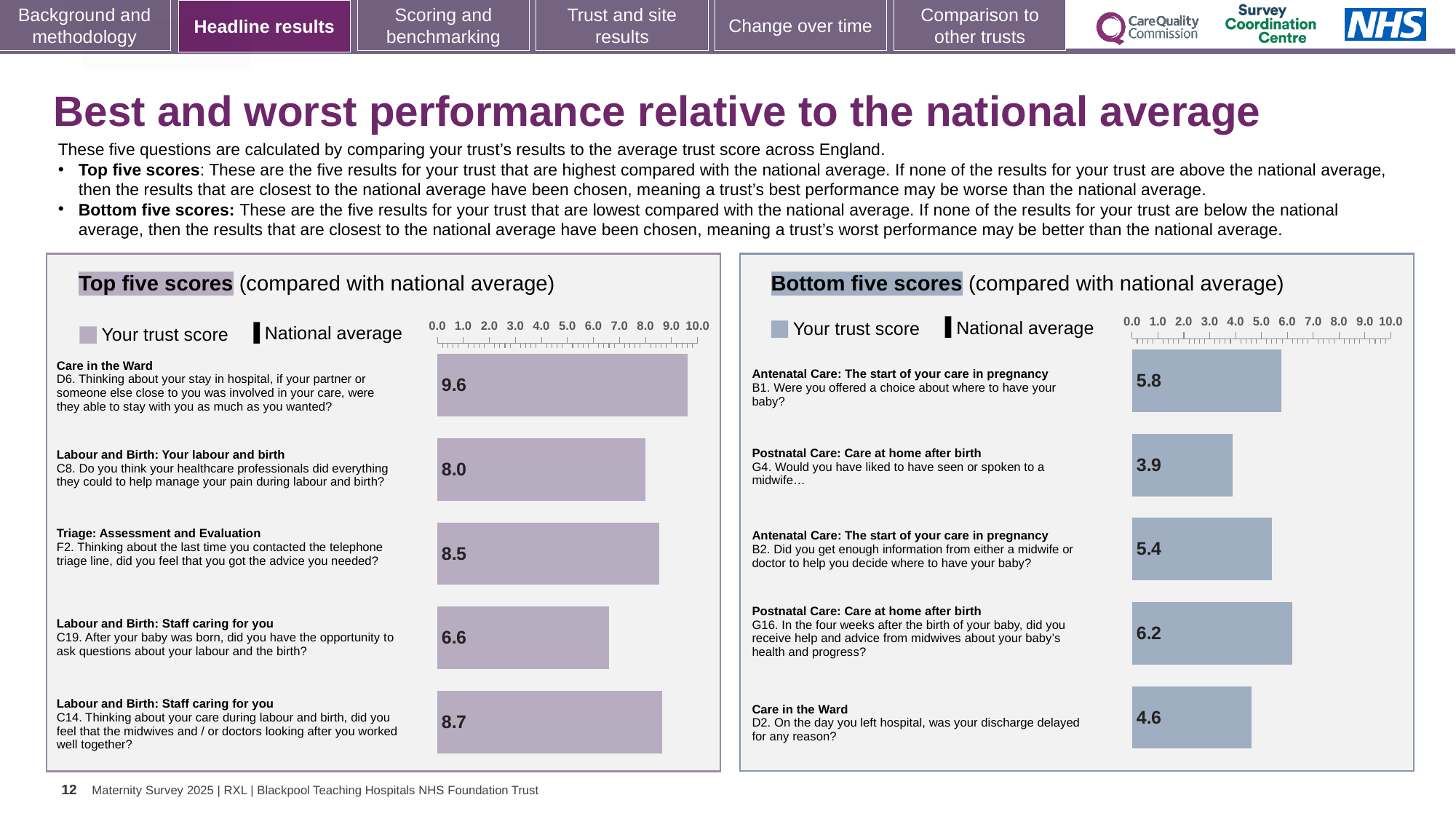
How many bars are plotted in the Bottom five scores chart? 5 In the Top five scores chart, which has the larger trust score: C8 or F2? F2 (8.5) What two entries does the legend of the Bottom five scores chart list? Your trust score; National average In the Top five scores chart, which question has the highest trust score? D6 (Care in the Ward), 9.6 In the Top five scores chart, what is the trust score for question D6 (Care in the Ward)? 9.6 In the Bottom five scores chart, which question has the lowest trust score? G4 (Postnatal Care: Care at home after birth), 3.9 In the Top five scores chart, which question has the lowest trust score? C19 (Labour and Birth: Staff caring for you), 6.6 In the Bottom five scores chart, which question has the highest trust score? G16 (Postnatal Care: Care at home after birth), 6.2 In the Bottom five scores chart, what is the difference between the trust scores for G16 and G4? 2.3 What type of chart is used in the Top five scores panel? Bar chart In the Bottom five scores chart, what is the trust score for question G4 (Postnatal Care: Care at home after birth)? 3.9 In the Top five scores chart, what is the difference between the trust scores for D6 and C19? 3.0